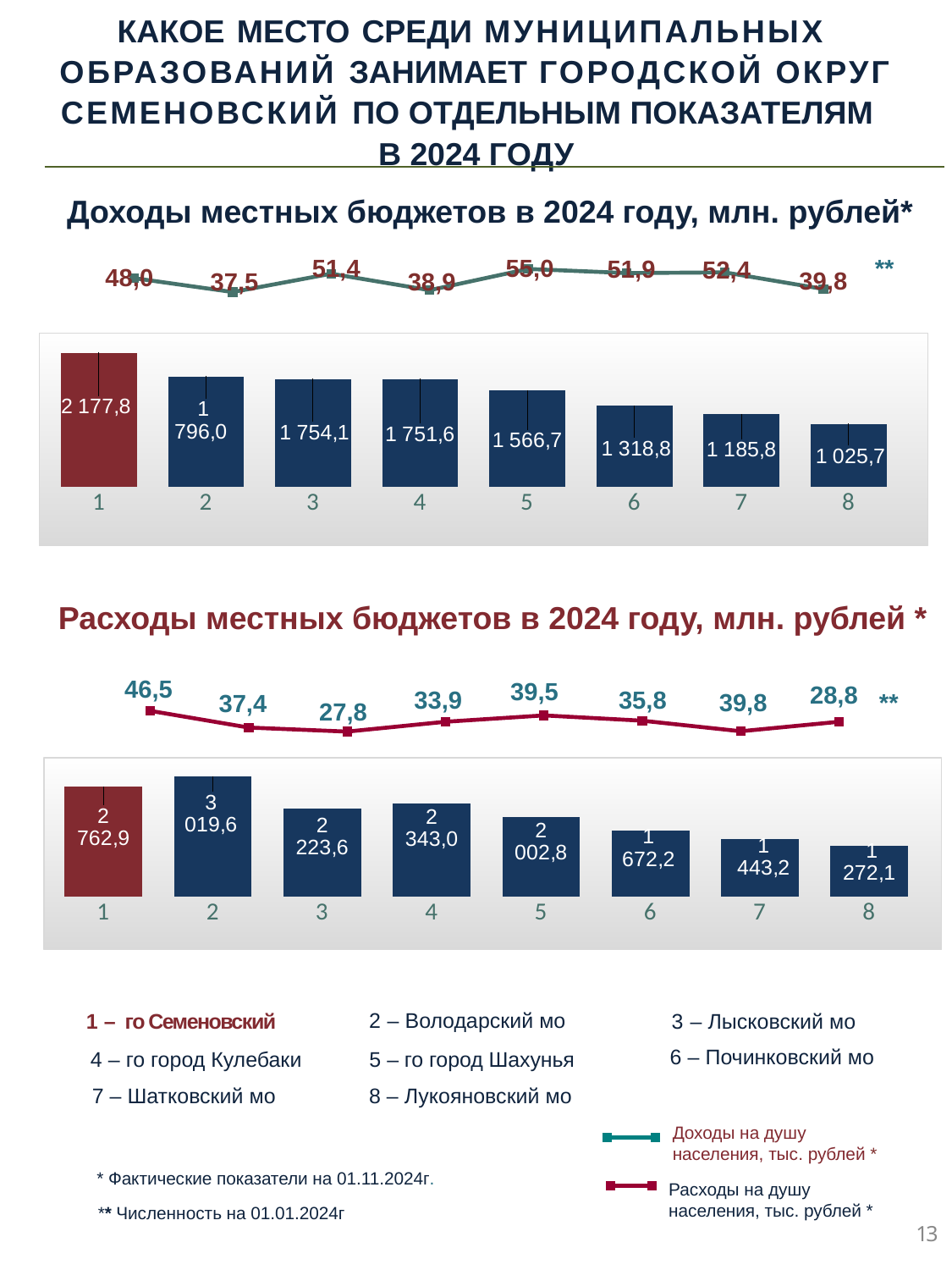
In the chart 'Доходы местных бюджетов в 2024 году, млн. рублей*', what is the value of the bar for category 8? 1 025,7 According to the legend on the slide, which municipality does category 1 represent? го Семеновский In the chart 'Доходы местных бюджетов в 2024 году, млн. рублей*', which category has the highest per-capita income value on the line? 5 In the chart 'Расходы местных бюджетов в 2024 году, млн. рублей *', which category has the lowest bar value? 8 In the chart 'Доходы местных бюджетов в 2024 году, млн. рублей*', how many bars are plotted? 8 In the chart 'Доходы местных бюджетов в 2024 году, млн. рублей*', what is the difference between the bar values for category 1 and category 2? 381,8 In the chart 'Доходы местных бюджетов в 2024 году, млн. рублей*', what is the value of the bar for category 1? 2 177,8 In the chart 'Расходы местных бюджетов в 2024 году, млн. рублей *', what is the per-capita expenditure value for category 1? 46,5 In the chart 'Расходы местных бюджетов в 2024 году, млн. рублей *', which category has the lowest per-capita expenditure value on the line? 3 In the chart 'Расходы местных бюджетов в 2024 году, млн. рублей *', do the bar values generally rise or fall from category 4 to category 8? fall In the chart 'Расходы местных бюджетов в 2024 году, млн. рублей *', what is the value of the bar for category 2? 3 019,6 In the chart 'Расходы местных бюджетов в 2024 году, млн. рублей *', which is larger: the bar for category 3 or the bar for category 4? category 4